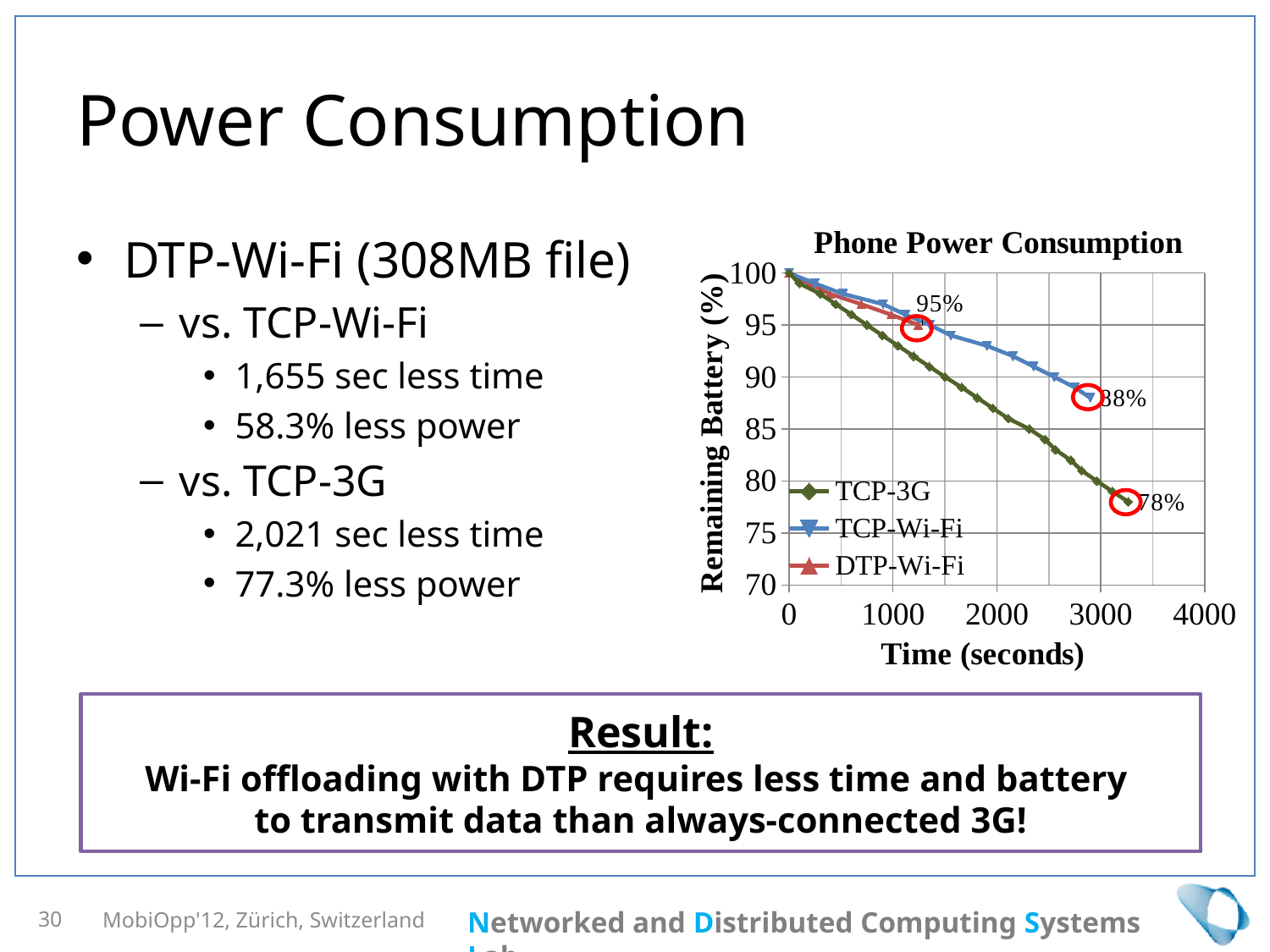
Which ends with more remaining battery, TCP-Wi-Fi or TCP-3G? TCP-Wi-Fi What kind of chart is shown on the slide? line chart What is the remaining battery percentage labelled at the end of the TCP-Wi-Fi line? 88% Is the remaining battery for TCP-3G at 2000 seconds greater or less than 90? less What is the remaining battery percentage labelled at the end of the DTP-Wi-Fi line? 95% How many series does the legend of the chart list? 3 Does the remaining battery rise or fall as time increases along the x axis? fall What is the difference between the labelled final remaining battery of TCP-Wi-Fi and TCP-3G? 10% What is the remaining battery percentage labelled at the end of the TCP-3G line? 78% Which series ends with the lowest labelled remaining battery? TCP-3G Which series ends with the highest labelled remaining battery? DTP-Wi-Fi What is the title of the chart? Phone Power Consumption